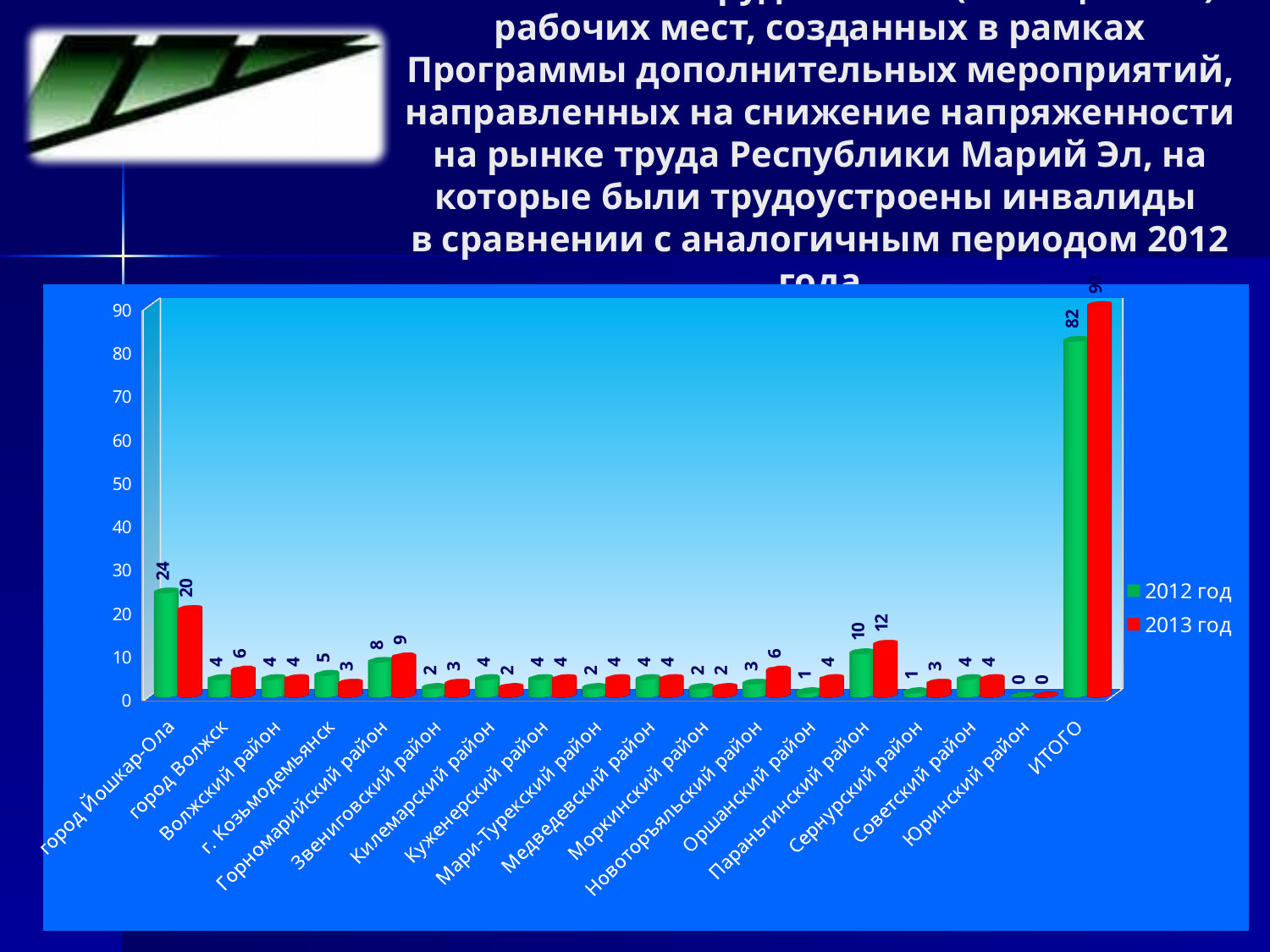
What is the 2012 год value for Оршанский район? 1 What kind of chart is shown on the slide? bar chart What is the 2012 год value for ИТОГО? 82 Which category has the lowest value in both series? Юринский район How many series does the legend list? 2 For Новоторъяльский район, which series has the larger value, 2012 год or 2013 год? 2013 год Is the 2013 год value for ИТОГО greater or less than 80? greater How many categories are shown on the x axis? 18 What is the difference between the 2012 год and 2013 год values for город Йошкар-Ола? 4 Apart from ИТОГО, which category has the highest 2013 год value? город Йошкар-Ола What is the value for город Йошкар-Ола in the 2012 год series? 24 What is the value for Параньгинский район in the 2013 год series? 12